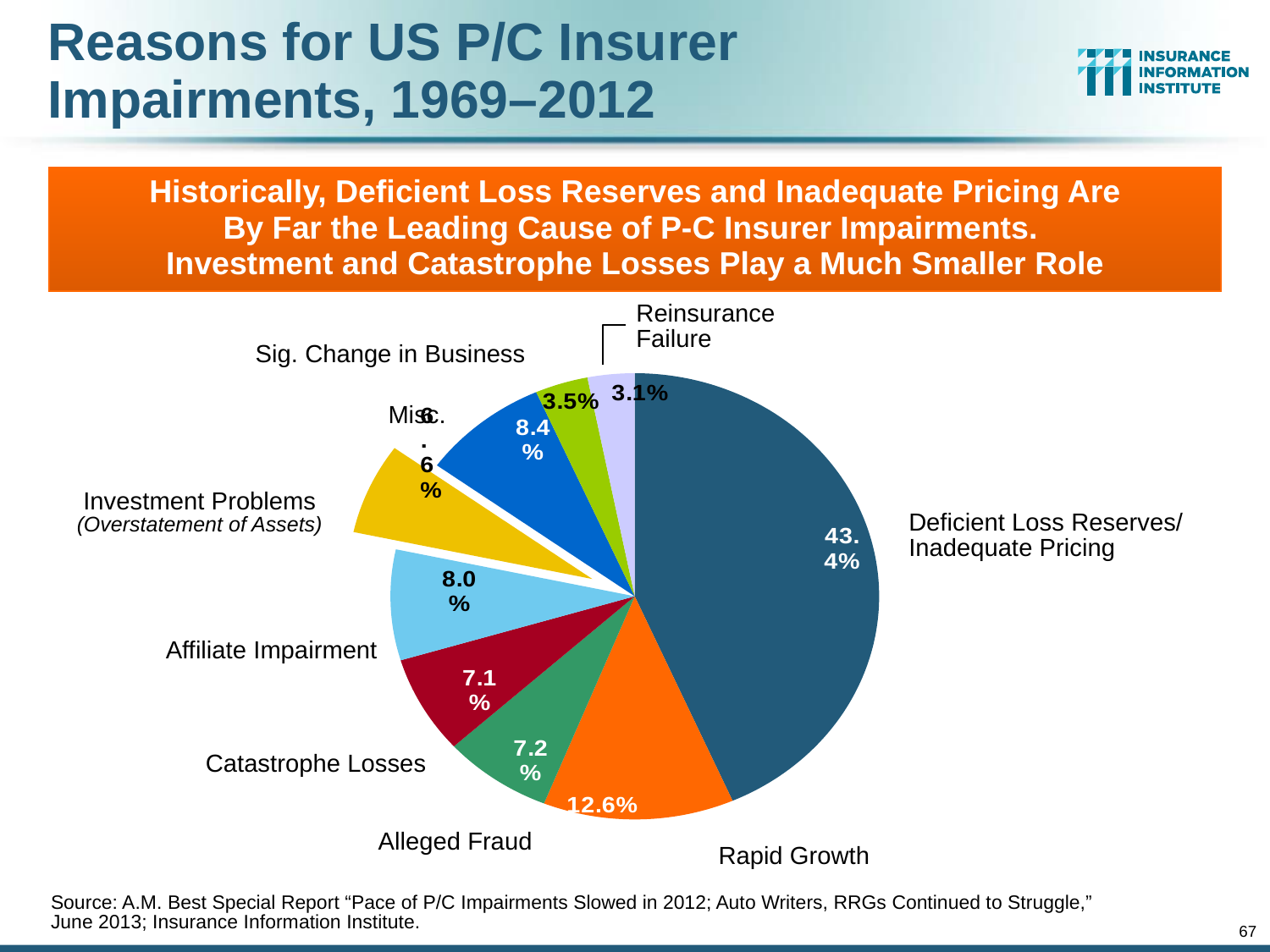
What kind of chart is shown on the slide? Pie chart What share of US P/C insurer impairments is attributed to Deficient Loss Reserves/Inadequate Pricing? 43.4% How many percentage points larger is the Deficient Loss Reserves/Inadequate Pricing share than the Rapid Growth share? 30.8 percentage points What percentage of impairments is attributed to Rapid Growth? 12.6% Which reason accounts for the largest share of impairments? Deficient Loss Reserves/Inadequate Pricing What percentage of impairments is attributed to Alleged Fraud? 7.2% Which has the larger share: Affiliate Impairment or Catastrophe Losses? Affiliate Impairment Which reason accounts for the smallest share of impairments? Reinsurance Failure How many reasons (slices) are shown in the pie chart? 9 What percentage of impairments is attributed to Catastrophe Losses? 7.1% What percentage of impairments is attributed to Affiliate Impairment? 8.0% What percentage of impairments is attributed to Reinsurance Failure? 3.1%